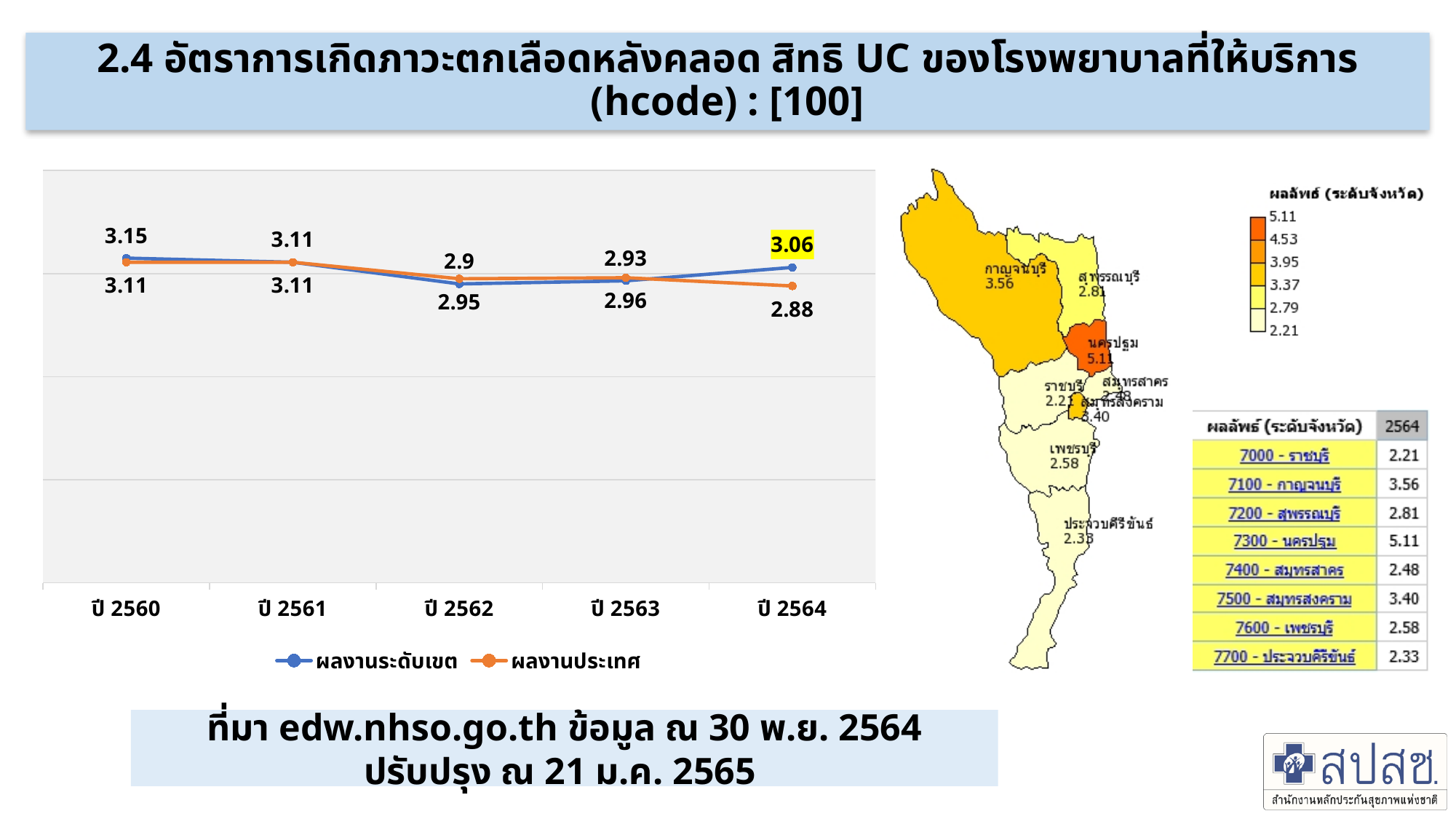
In the line chart, what is the value of ผลงานประเทศ for ปี 2564? 2.88 In the line chart, what is the value of ผลงานระดับเขต for ปี 2564? 3.06 In the line chart, in which year is ผลงานระดับเขต highest? ปี 2560 In the line chart, what is the difference between ผลงานระดับเขต and ผลงานประเทศ in ปี 2564? 0.18 In the line chart, what is the value of ผลงานระดับเขต for ปี 2560? 3.15 In the line chart, in which year is ผลงานประเทศ lowest? ปี 2564 What kind of chart is shown on the left of the slide? line chart How many series does the legend of the line chart list? 2 How many years are plotted along the x axis of the line chart? 5 In the line chart, which series has the higher value in ปี 2564? ผลงานระดับเขต In the line chart, does ผลงานประเทศ rise or fall from ปี 2563 to ปี 2564? fall In the line chart, which data label is highlighted in yellow? 3.06